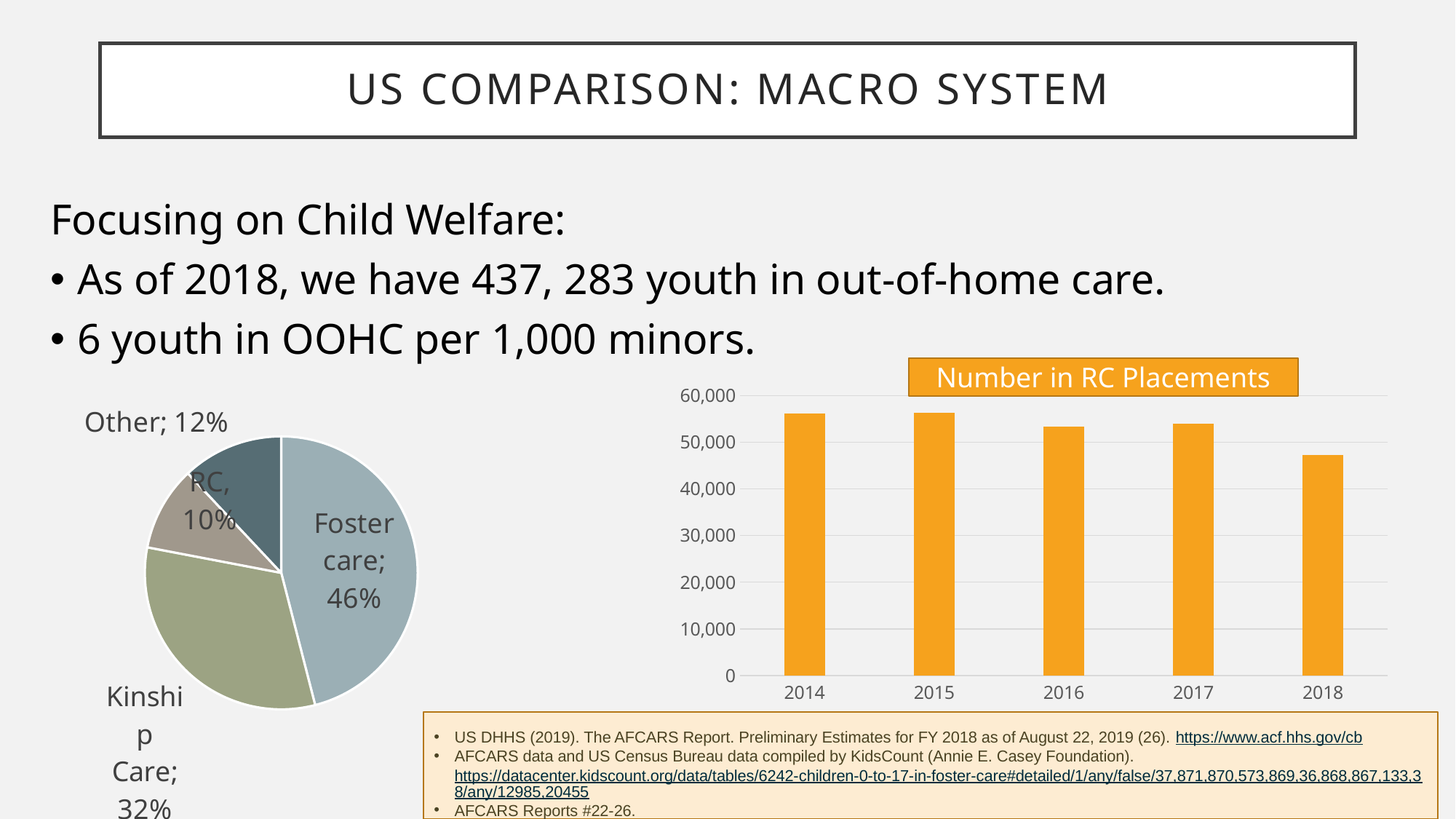
What kind of chart is 'Number in RC Placements'? bar chart How many slices does the pie chart on the left have? 4 In the pie chart on the left, how many percentage points larger is Foster care than Kinship Care? 14 How many years are shown on the x axis of the 'Number in RC Placements' chart? 5 In the pie chart on the left, which category has the largest slice? Foster care In the pie chart on the left, what share is labelled for RC? 10% In the pie chart on the left, what share is labelled for Foster care? 46% In the 'Number in RC Placements' chart, is the value for 2014 larger or smaller than the value for 2018? larger In the pie chart on the left, what share is labelled for Kinship Care? 32% In the 'Number in RC Placements' chart, is the value for 2018 greater or less than 50,000? less In the pie chart on the left, which category has the smallest slice? RC In the 'Number in RC Placements' chart, which year has the lowest value? 2018